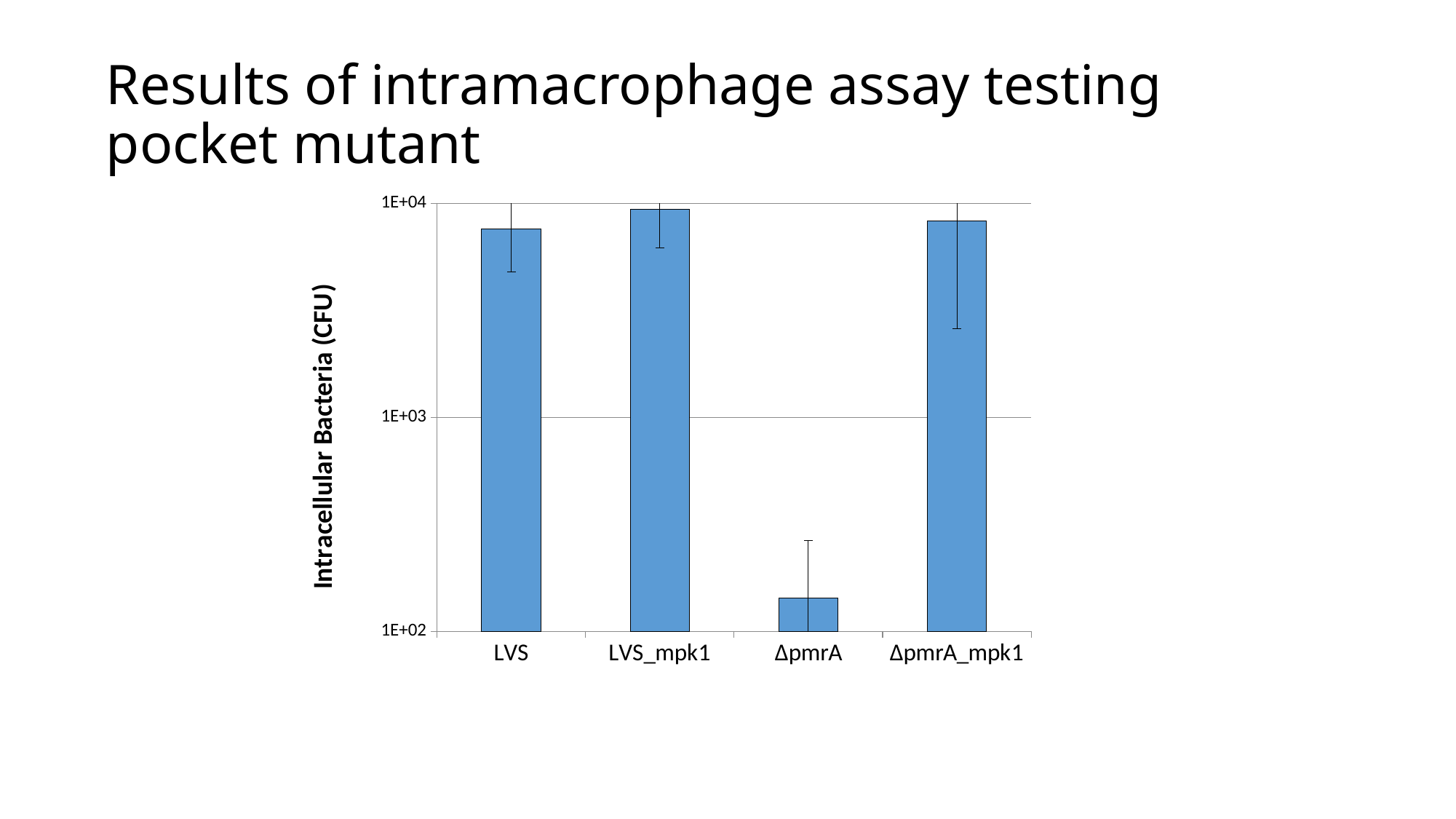
What is the label of the y axis of the chart? Intracellular Bacteria (CFU) What kind of chart is shown on the slide? bar chart What is the title of the slide containing the chart? Results of intramacrophage assay testing pocket mutant Is the value for LVS greater or less than 1E+03? greater Which is larger, the value for LVS or the value for ΔpmrA? LVS Is the value for ΔpmrA_mpk1 greater or less than 1E+03? greater Which category has the lowest intracellular bacteria value? ΔpmrA Which is larger, the value for ΔpmrA_mpk1 or the value for ΔpmrA? ΔpmrA_mpk1 Is the value for LVS_mpk1 greater or less than 1E+04? less How many categories are plotted on the x axis of the chart? 4